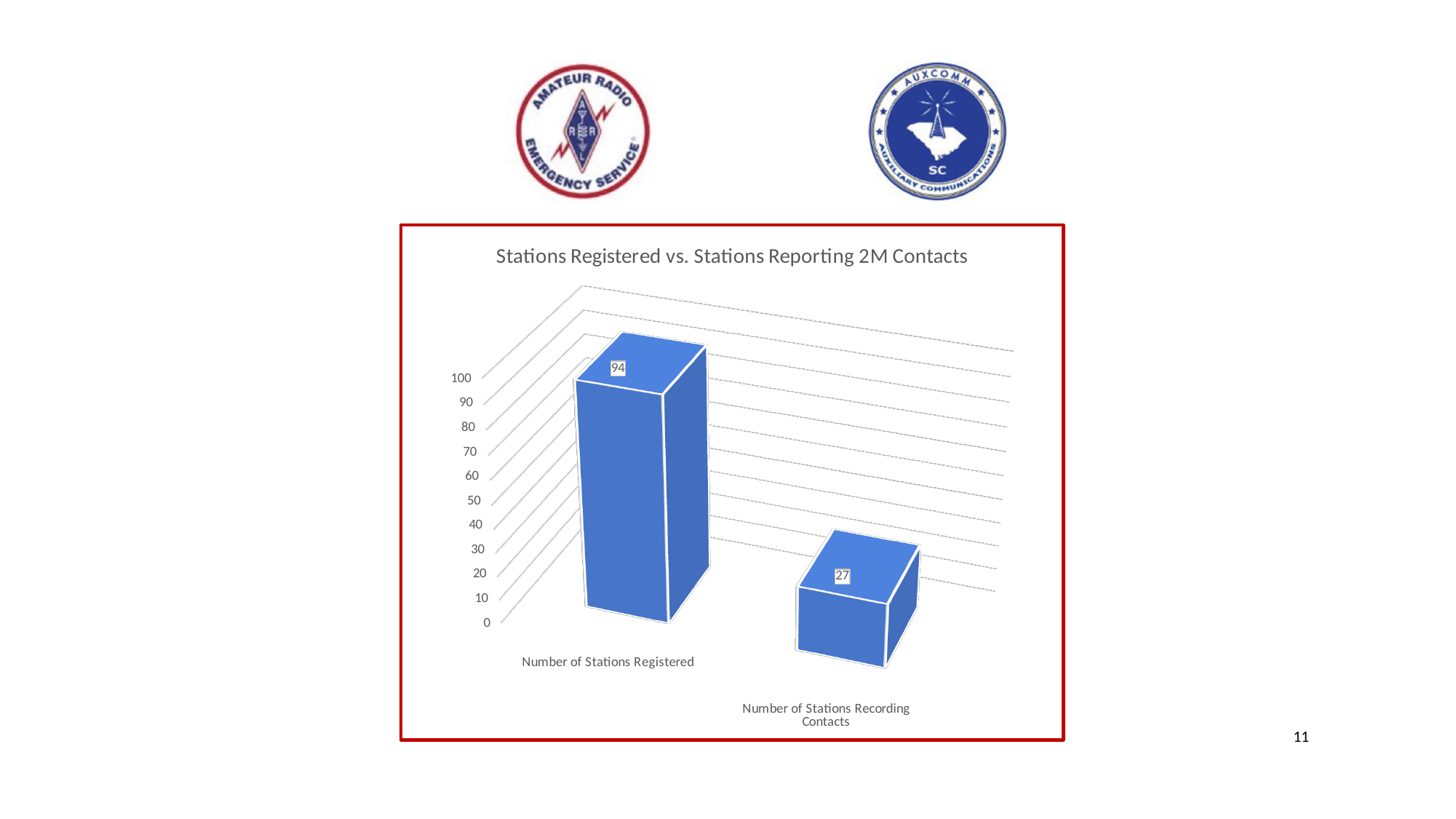
Is the value for Number of Stations Recording Contacts greater or less than 50? less Is the value for Number of Stations Registered greater or less than 80? greater What is the title of the chart? Stations Registered vs. Stations Reporting 2M Contacts What is the value for Number of Stations Registered? 94 Which is larger: Number of Stations Registered or Number of Stations Recording Contacts? Number of Stations Registered What is the difference between Number of Stations Registered and Number of Stations Recording Contacts? 67 Which category has the lowest value? Number of Stations Recording Contacts What kind of chart is shown on the slide? bar chart Which category has the highest value? Number of Stations Registered What is the value for Number of Stations Recording Contacts? 27 What is the maximum value shown on the vertical axis? 100 How many categories are shown in the chart? 2